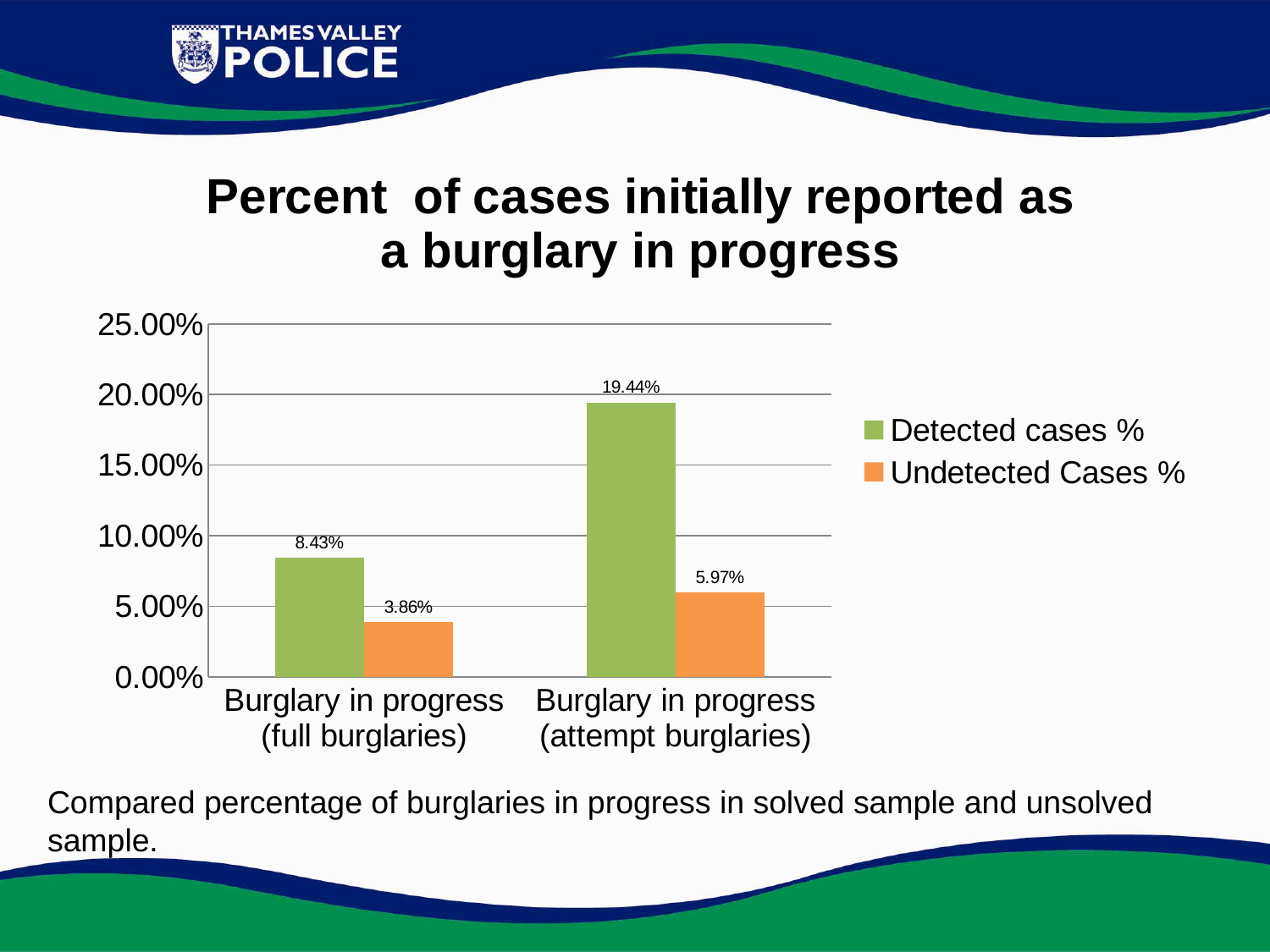
How many series does the legend list? 2 What is the Undetected Cases % value for Burglary in progress (full burglaries)? 3.86% What colour represents Undetected Cases % in the chart? Orange Which bar on the chart has the lowest value? Undetected Cases % for Burglary in progress (full burglaries) What is the Undetected Cases % value for Burglary in progress (attempt burglaries)? 5.97% Which category has the highest Detected cases % value? Burglary in progress (attempt burglaries) What is the Detected cases % value for Burglary in progress (full burglaries)? 8.43% Is the Detected cases % value for Burglary in progress (attempt burglaries) greater or less than 15.00%? greater How many categories are shown on the x axis? 2 What kind of chart is shown on the slide? Bar chart What is the difference between the Detected cases % and Undetected Cases % values for Burglary in progress (attempt burglaries)? 13.47% Which is larger for Burglary in progress (full burglaries): Detected cases % or Undetected Cases %? Detected cases %